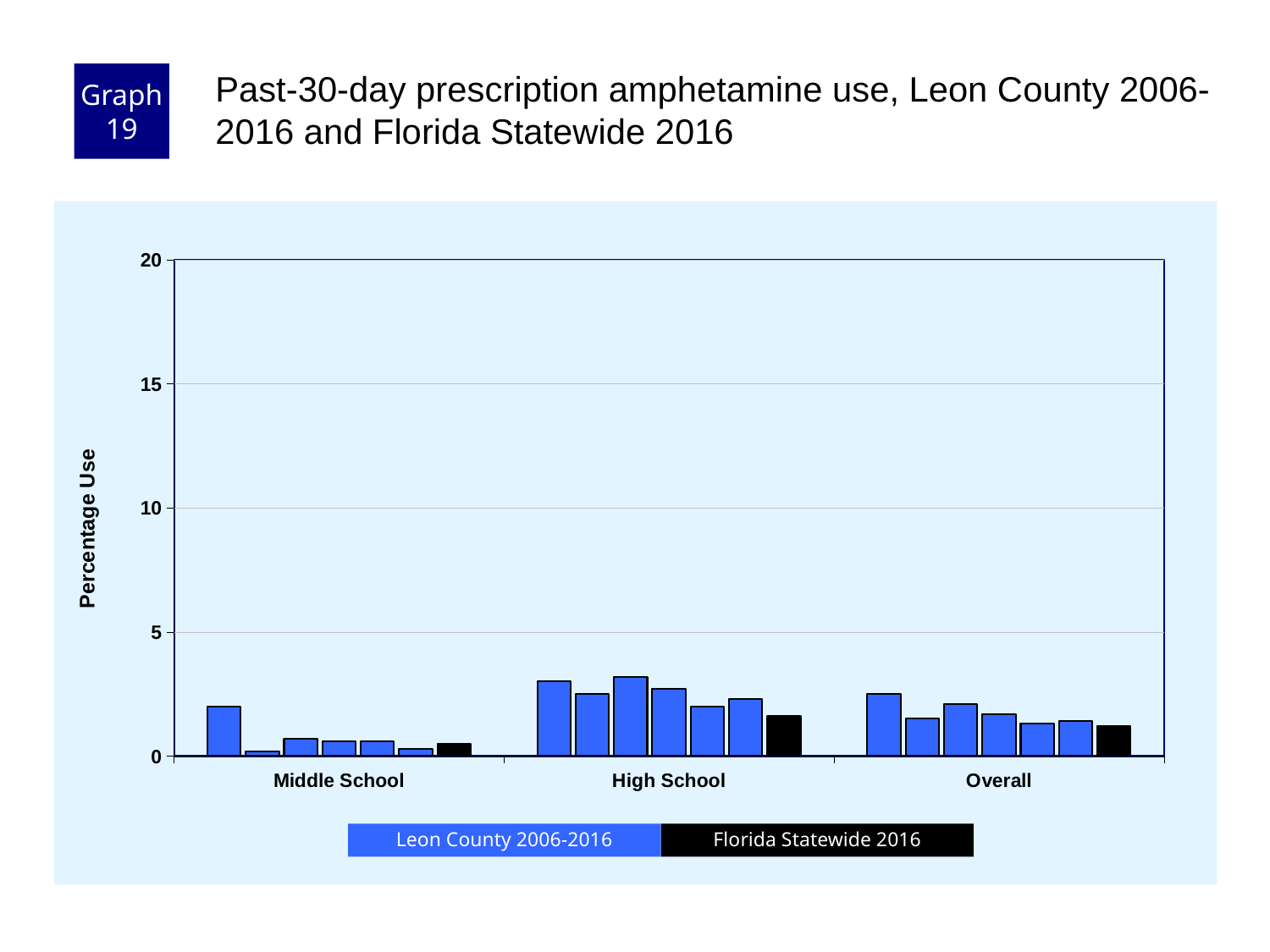
In which category is the Florida Statewide 2016 bar the lowest? Middle School How many series does the legend list? 2 How many bars are plotted in the High School category? 7 How many categories are shown on the x axis? 3 What kind of chart is shown on the slide? Bar chart Is the tallest Leon County bar in the Middle School category greater or less than 5? less What colour represents Florida Statewide 2016 in the legend? Black Is the Florida Statewide 2016 value for High School greater or less than 5? less Which category has the tallest bars overall? High School Which is larger: the Florida Statewide 2016 bar for High School or the Florida Statewide 2016 bar for Middle School? High School In the Middle School category, which is larger: the first Leon County bar or the Florida Statewide 2016 bar? The first Leon County bar What is the label on the y axis? Percentage Use